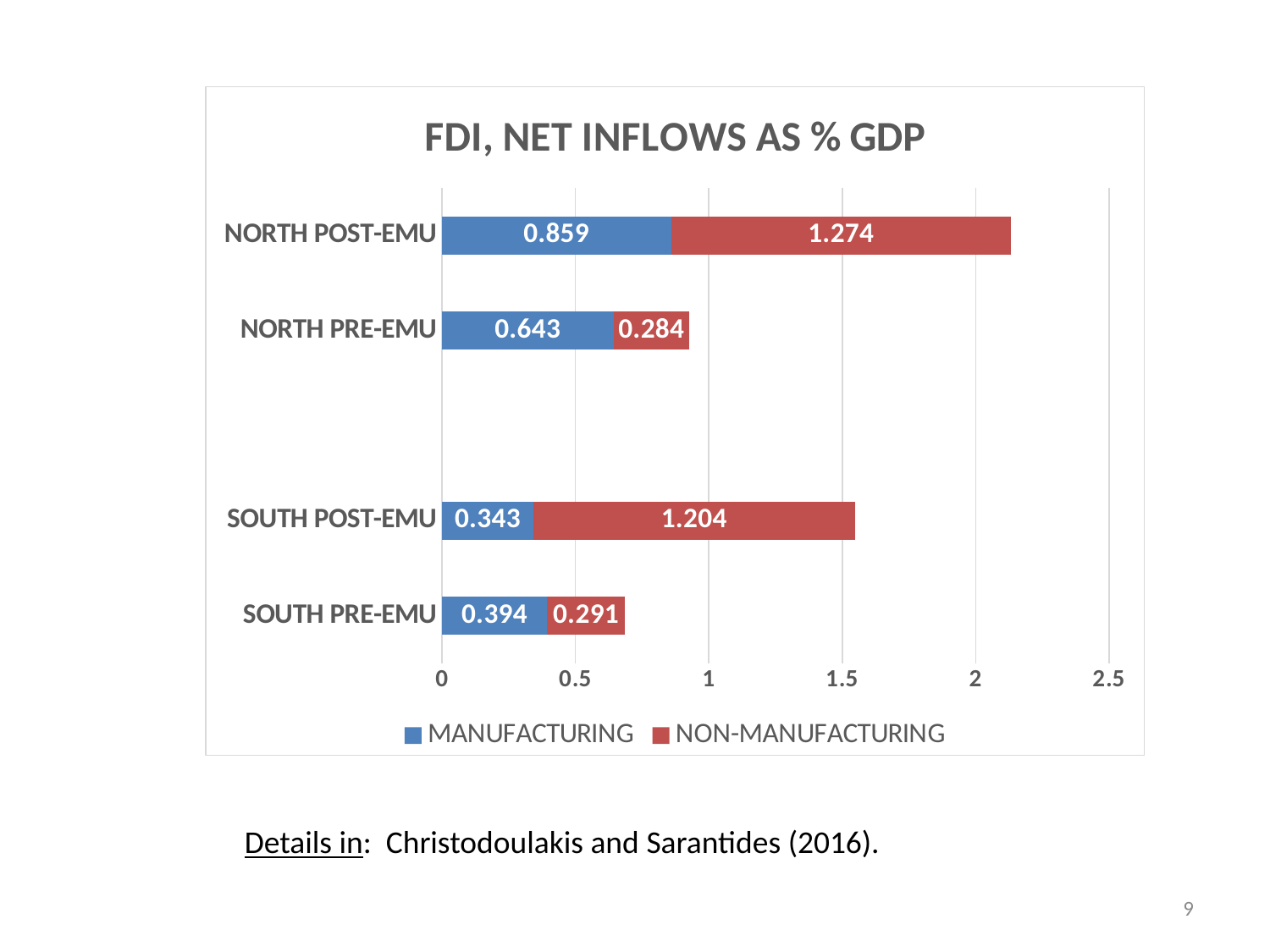
What is the MANUFACTURING value for NORTH POST-EMU? 0.859 Which category has the lowest MANUFACTURING value? SOUTH POST-EMU What is the total of the stacked bar for SOUTH PRE-EMU? 0.685 What is the NON-MANUFACTURING value for NORTH PRE-EMU? 0.284 What is the total of the stacked bar for NORTH POST-EMU? 2.133 Which is larger, the MANUFACTURING value for SOUTH PRE-EMU or for SOUTH POST-EMU? SOUTH PRE-EMU Is the total stacked bar for NORTH PRE-EMU greater or less than 1? less What is the NON-MANUFACTURING value for SOUTH POST-EMU? 1.204 What is the difference between the NON-MANUFACTURING values for NORTH POST-EMU and SOUTH POST-EMU? 0.07 How many series does the legend list? 2 What kind of chart is shown on the slide? Stacked bar chart Which category has the highest MANUFACTURING value? NORTH POST-EMU